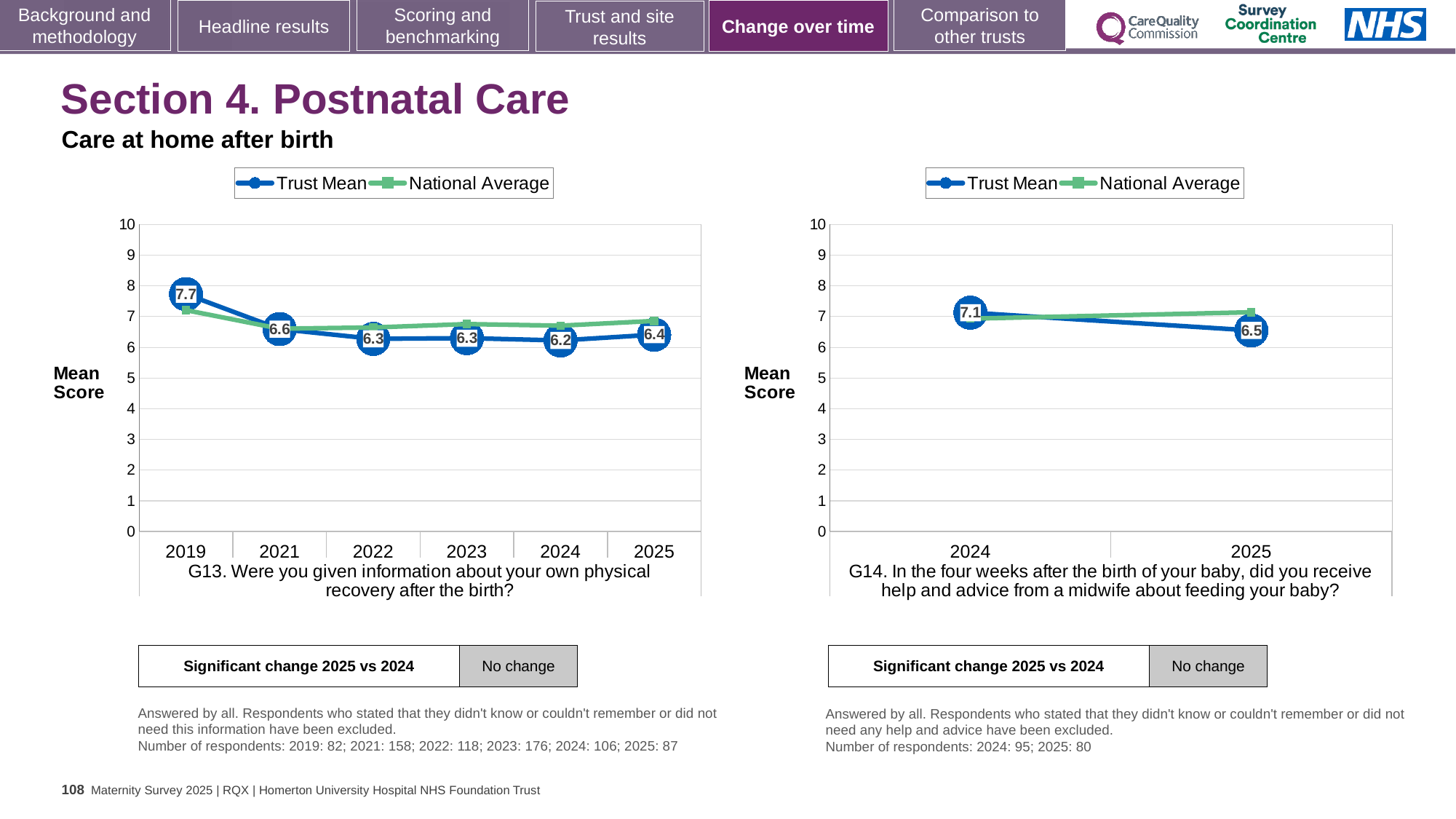
In the G14 chart, what is the Trust Mean score for 2025? 6.5 What type of chart is the G13 chart? line chart In the G13 chart, how many years are plotted on the x axis? 6 In the G14 chart, how many series does the legend list? 2 In the G13 chart, what is the difference between the Trust Mean scores for 2019 and 2021? 1.1 In the G13 chart, is the National Average for 2019 greater or less than 8? less In the G14 chart, what is the Trust Mean score for 2024? 7.1 In the G14 chart, does the Trust Mean rise or fall from 2024 to 2025? fall In the G13 chart, which year has the highest Trust Mean score? 2019 In the G13 chart, what is the Trust Mean score for 2019? 7.7 In the G13 chart, what is the Trust Mean score for 2025? 6.4 In the G13 chart, which year has the lowest Trust Mean score? 2024